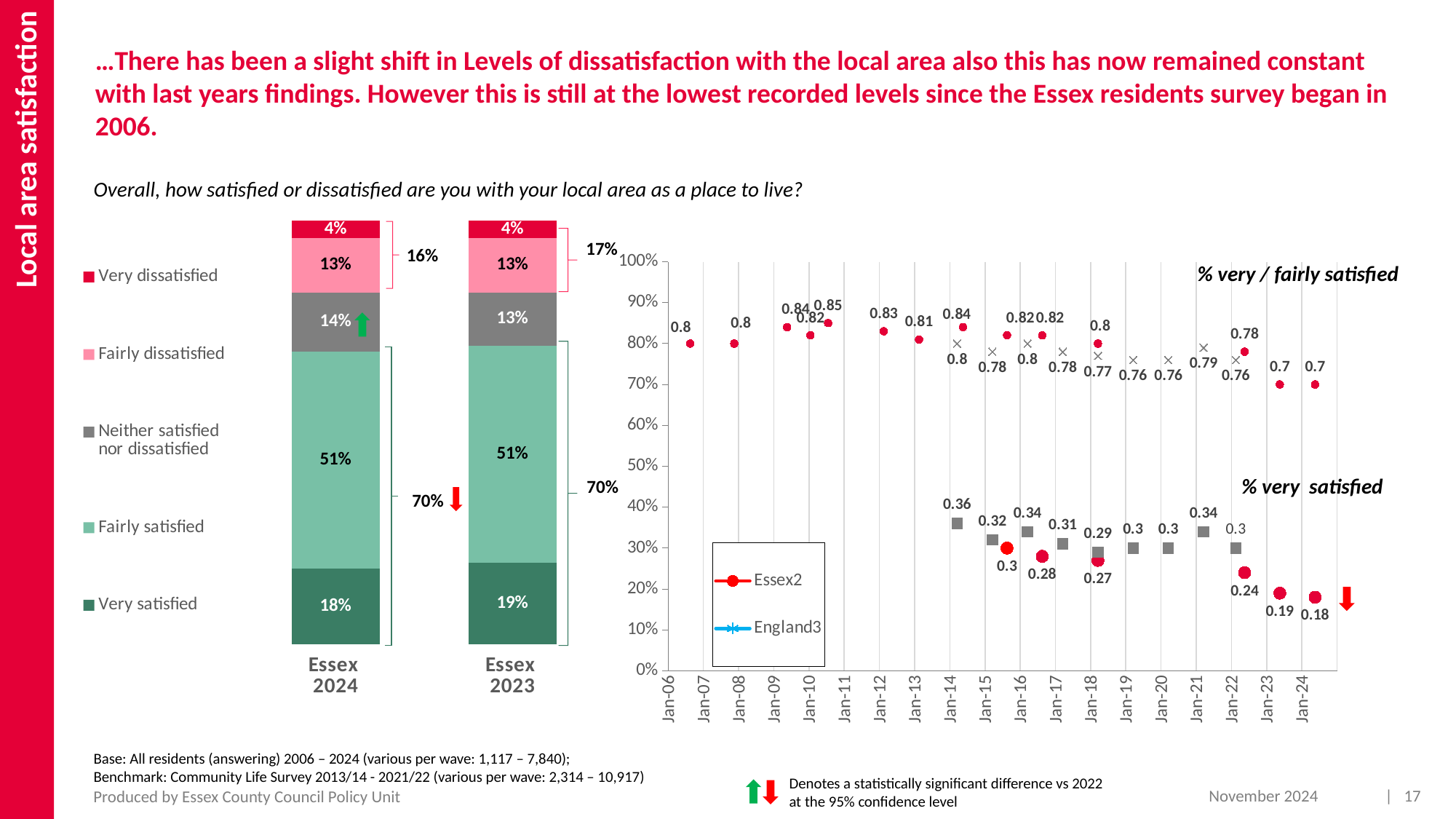
In the chart on the right, what is the Essex2 value for % very satisfied at Jan-22? 0.24 In the stacked bar chart on the left, what is the difference between the very satisfied percentages for Essex 2023 and Essex 2024? 1% In the stacked bar chart on the left, which response category is the smallest for Essex 2023? Very dissatisfied In the stacked bar chart on the left, what percentage of Essex 2024 respondents were very satisfied? 18% In the chart on the right, does the Essex2 % very satisfied series rise or fall from Jan-15 to Jan-24? fall In the stacked bar chart on the left, what percentage of Essex 2024 respondents were fairly dissatisfied? 13% In the chart on the right, what is the England3 value for % very / fairly satisfied at Jan-21? 0.79 In the stacked bar chart on the left, what is the combined very satisfied and fairly satisfied percentage shown for Essex 2024? 70% In the stacked bar chart on the left, what percentage of Essex 2023 respondents were neither satisfied nor dissatisfied? 13% In the stacked bar chart on the left, which response category is the largest for Essex 2024? Fairly satisfied In the stacked bar chart on the left, how many response categories does the legend list? 5 In the chart on the right, what is the Essex2 value for % very / fairly satisfied at Jan-24? 0.7